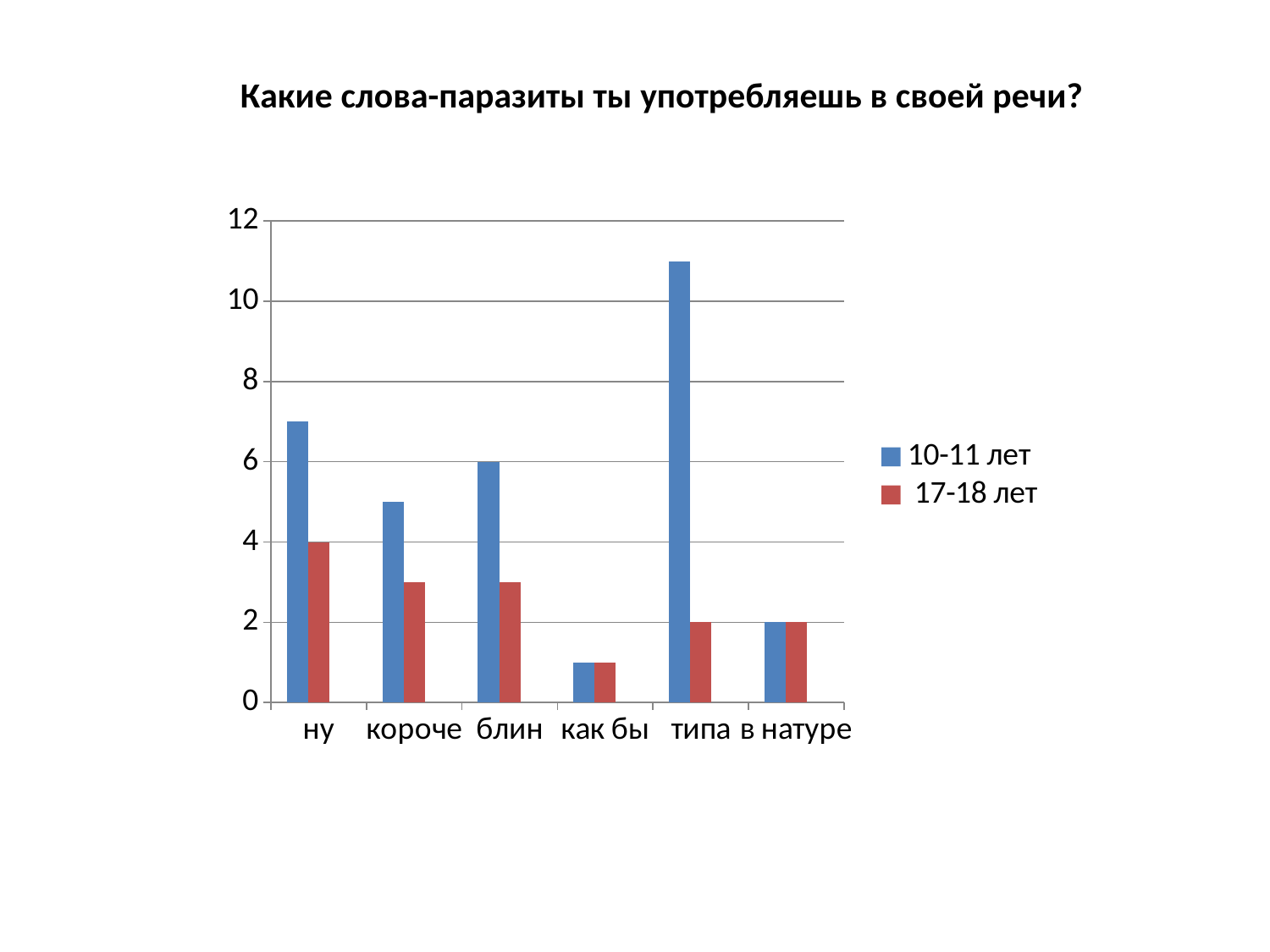
What is the title of the chart? Какие слова-паразиты ты употребляешь в своей речи? What is the value for "ну" in the "17-18 лет" series? 4 How many series does the legend list? 2 How many categories are shown on the x axis? 6 Which category has the highest value in the "10-11 лет" series? типа For "короче", which series has the larger value, "10-11 лет" or "17-18 лет"? 10-11 лет Which category has the lowest value in the "17-18 лет" series? как бы What is the value for "в натуре" in the "10-11 лет" series? 2 Is the value for "типа" in the "10-11 лет" series greater or less than 10? greater Is the value for "ну" in the "10-11 лет" series greater or less than 6? greater What is the value for "блин" in the "10-11 лет" series? 6 What type of chart is shown on the slide? Bar chart